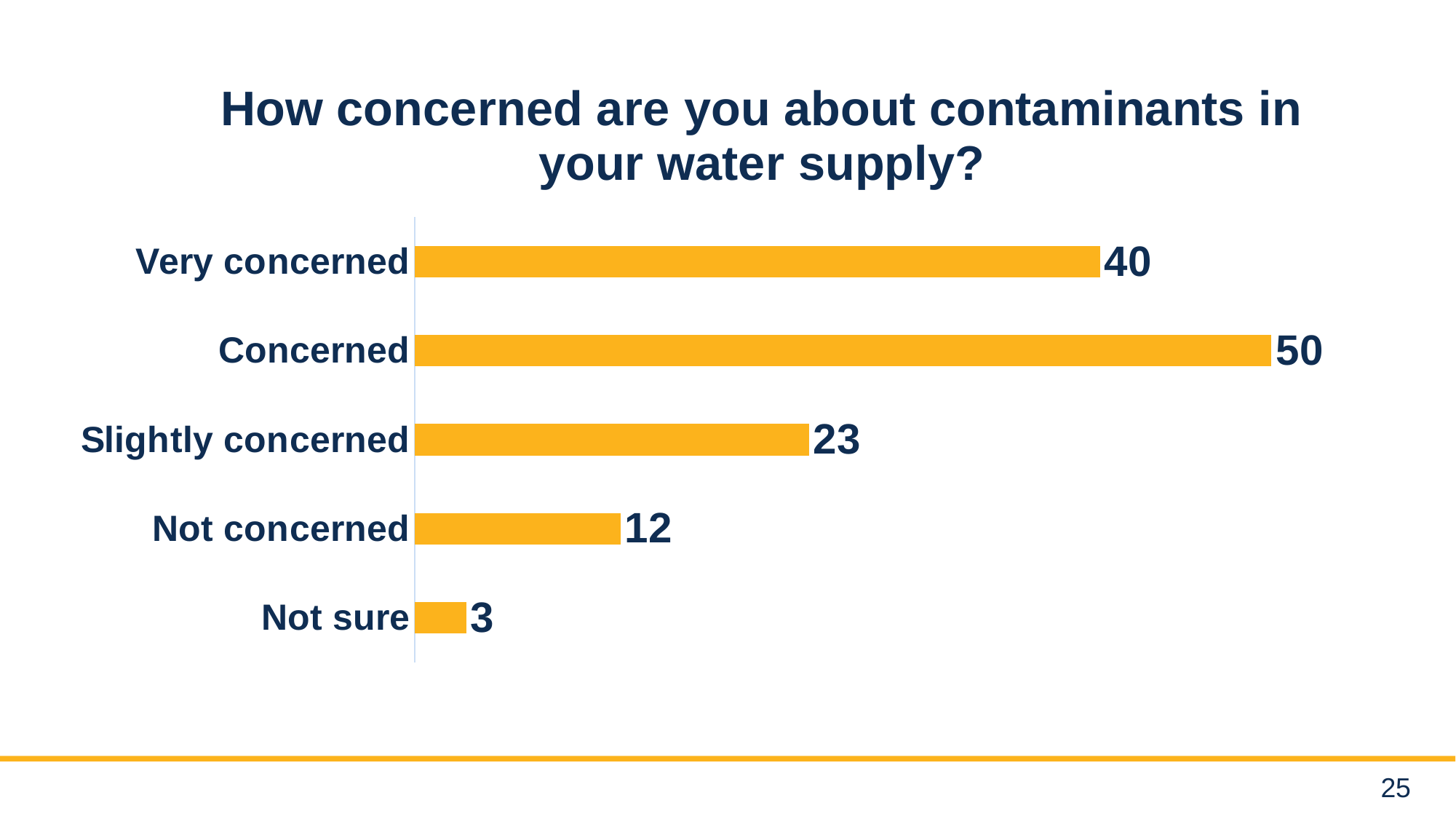
What is the value for Very concerned? 40 Which category has the lowest value? Not sure What is the difference between the values for Concerned and Very concerned? 10 Which is larger, the value for Very concerned or the value for Slightly concerned? Very concerned What is the value for Not sure? 3 What is the value for Not concerned? 12 What is the difference between the values for Slightly concerned and Not concerned? 11 How many categories are shown in the chart? 5 What is the value for Concerned? 50 What is the value for Slightly concerned? 23 What kind of chart is shown on the slide? Bar chart Which category has the highest value? Concerned